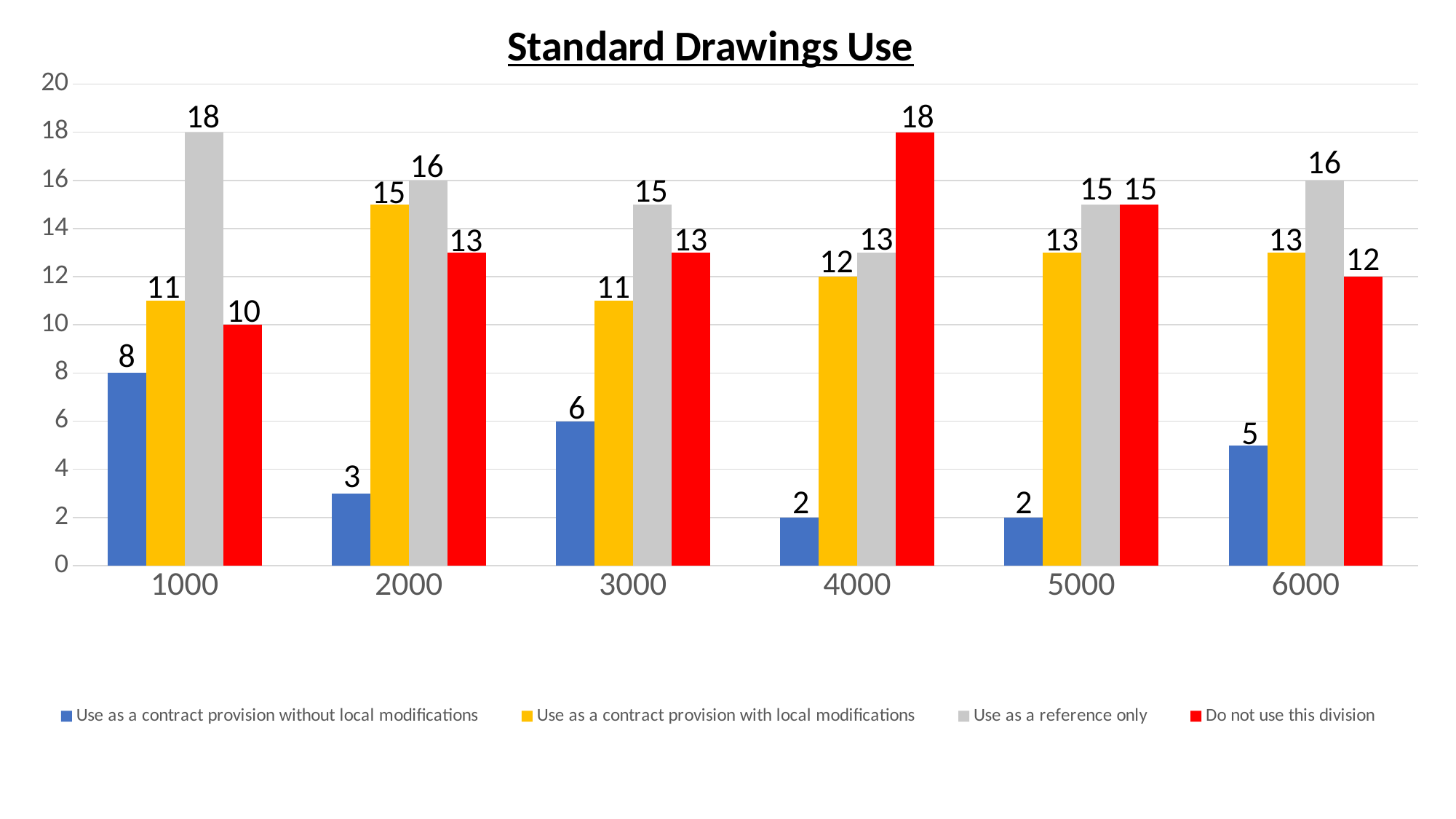
What is the title of the chart? Standard Drawings Use Which category has the lowest value for 'Do not use this division'? 1000 What is the value for 'Use as a reference only' in the 1000 category? 18 How many series does the legend list? 4 What is the difference between 'Use as a reference only' and 'Use as a contract provision without local modifications' in the 1000 category? 10 In the 2000 category, which is larger: 'Use as a contract provision with local modifications' or 'Do not use this division'? Use as a contract provision with local modifications What is the value for 'Do not use this division' in the 4000 category? 18 How many categories are shown on the x axis? 6 Which colour represents 'Do not use this division' in the chart? Red What kind of chart is shown on the slide? Bar chart What is the value for 'Use as a contract provision without local modifications' in the 6000 category? 5 Which category has the highest value for 'Use as a contract provision without local modifications'? 1000